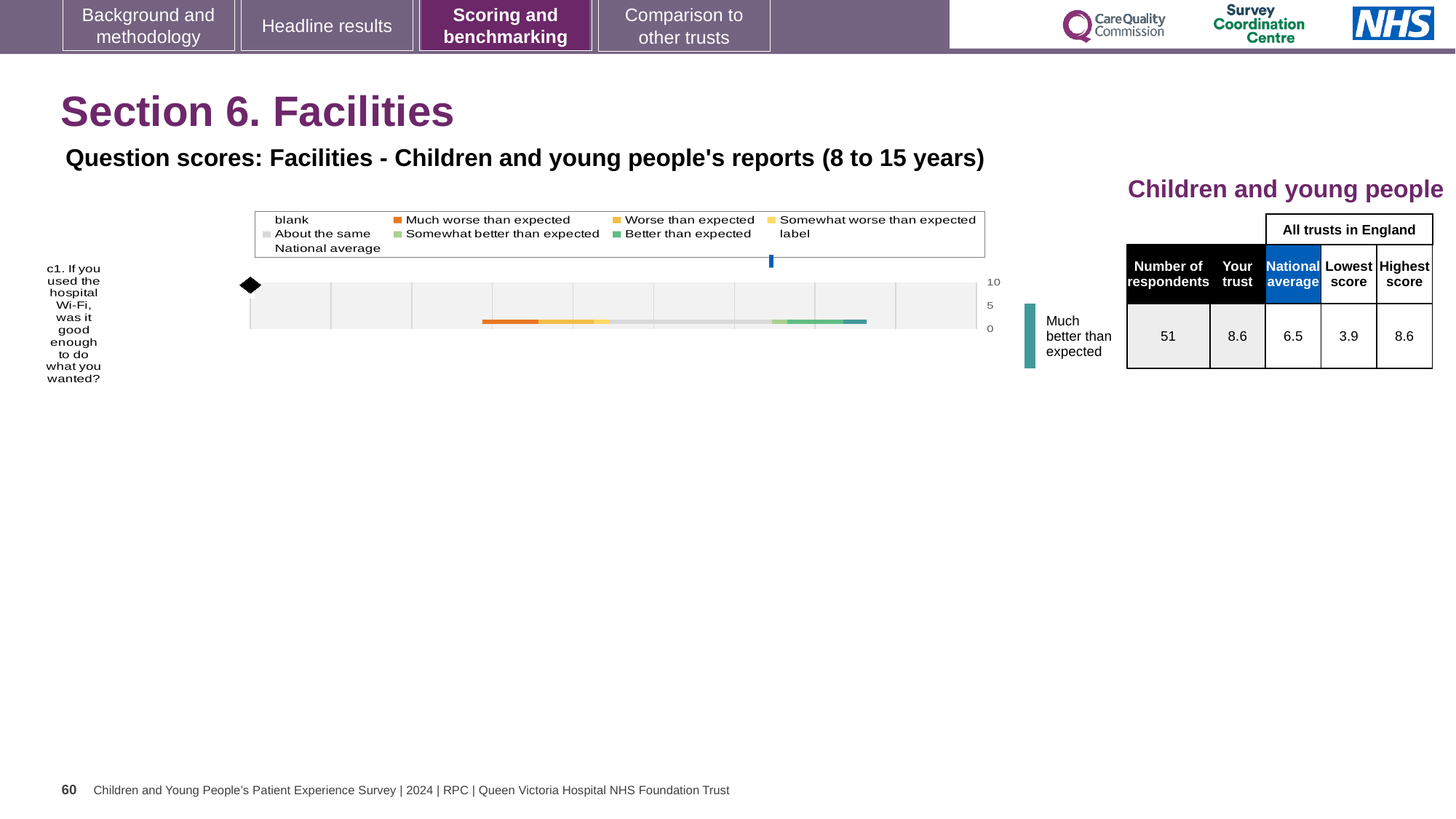
What is the 'Your trust' score for question c1? 8.6 Which is larger for question c1: the 'Your trust' score or the national average? Your trust What kind of chart is shown on the slide? bar chart What is the highest score among all trusts in England for question c1? 8.6 How many respondents answered question c1? 51 Which survey question is plotted in the chart? c1. If you used the hospital Wi-Fi, was it good enough to do what you wanted? What benchmark category label is shown next to the chart for question c1? Much better than expected How many questions (categories) are plotted in the chart? 1 What is the difference between the highest and lowest scores for question c1? 4.7 By how much does the 'Your trust' score for question c1 exceed the national average? 2.1 What is the lowest score among all trusts in England for question c1? 3.9 What is the national average score for question c1? 6.5